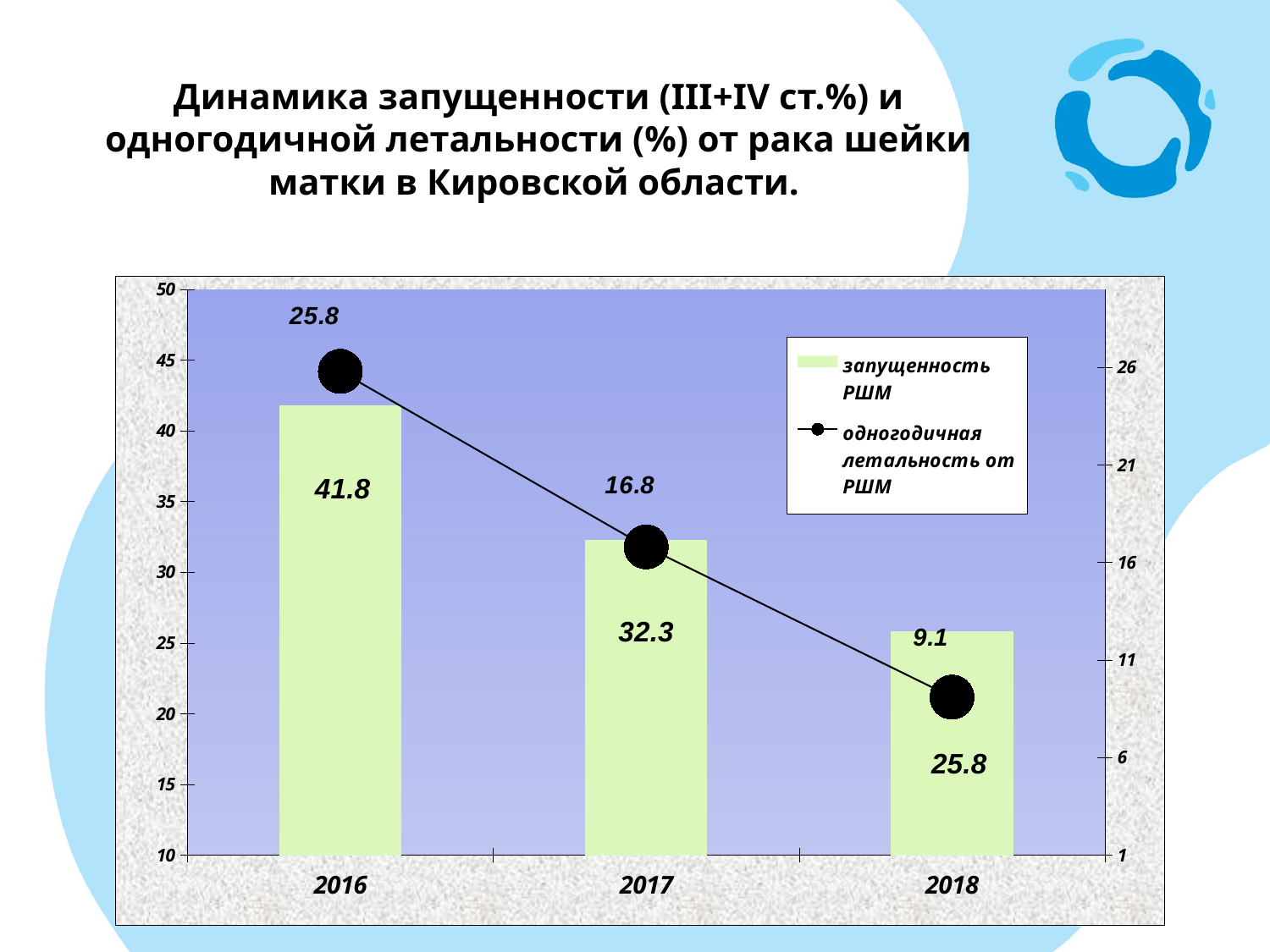
How many series does the legend list? 2 What is the difference between одногодичная летальность от РШМ in 2016 and 2017? 9 How many years are shown on the x axis? 3 In which year is одногодичная летальность от РШМ lowest? 2018 What is the value of запущенность РШМ for 2017? 32.3 What is the value of одногодичная летальность от РШМ for 2018? 9.1 What is the value of одногодичная летальность от РШМ for 2017? 16.8 Which is larger: запущенность РШМ in 2017 or in 2018? 2017 What is the value of запущенность РШМ for 2016? 41.8 What is the difference between запущенность РШМ in 2016 and 2018? 16 In which year is запущенность РШМ highest? 2016 Do the values of одногодичная летальность от РШМ rise or fall from 2016 to 2018? fall